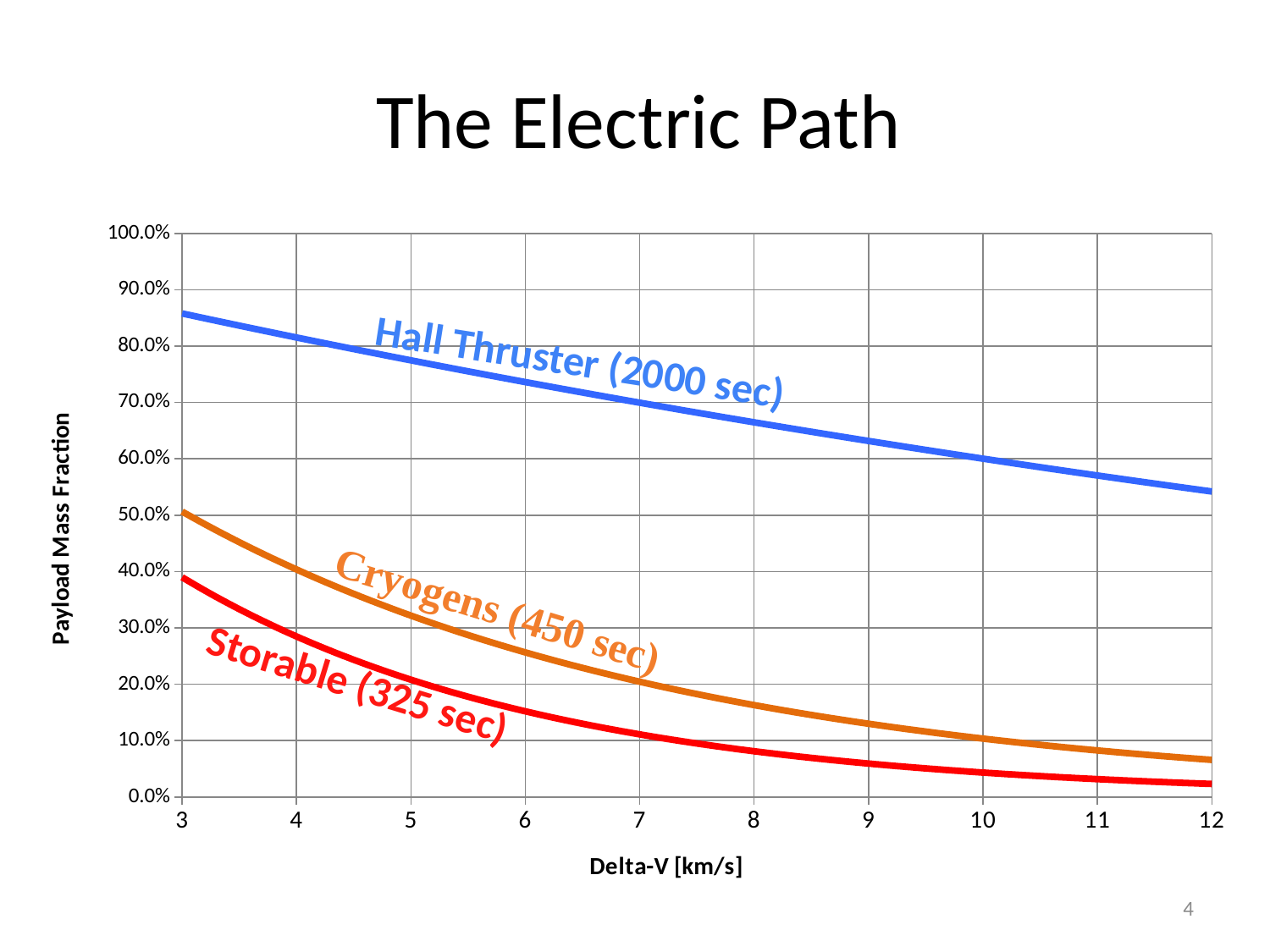
Is the payload mass fraction for Hall Thruster (2000 sec) at 3 km/s greater or less than 80.0%? greater How many series (curves) are plotted on the chart? 3 What kind of chart is shown on the slide? Line chart At a Delta-V of 9 km/s, which has the larger payload mass fraction: Cryogens (450 sec) or Storable (325 sec)? Cryogens (450 sec) Is the payload mass fraction for Hall Thruster (2000 sec) at 12 km/s greater or less than 50.0%? greater Is the payload mass fraction for Storable (325 sec) at 3 km/s greater or less than 30.0%? greater What is the label of the x axis? Delta-V [km/s] What is the label of the y axis? Payload Mass Fraction Which series has the lowest payload mass fraction across the whole Delta-V range? Storable (325 sec) Does the payload mass fraction rise or fall as Delta-V increases for each series? Fall Which series has the highest payload mass fraction across the whole Delta-V range? Hall Thruster (2000 sec)